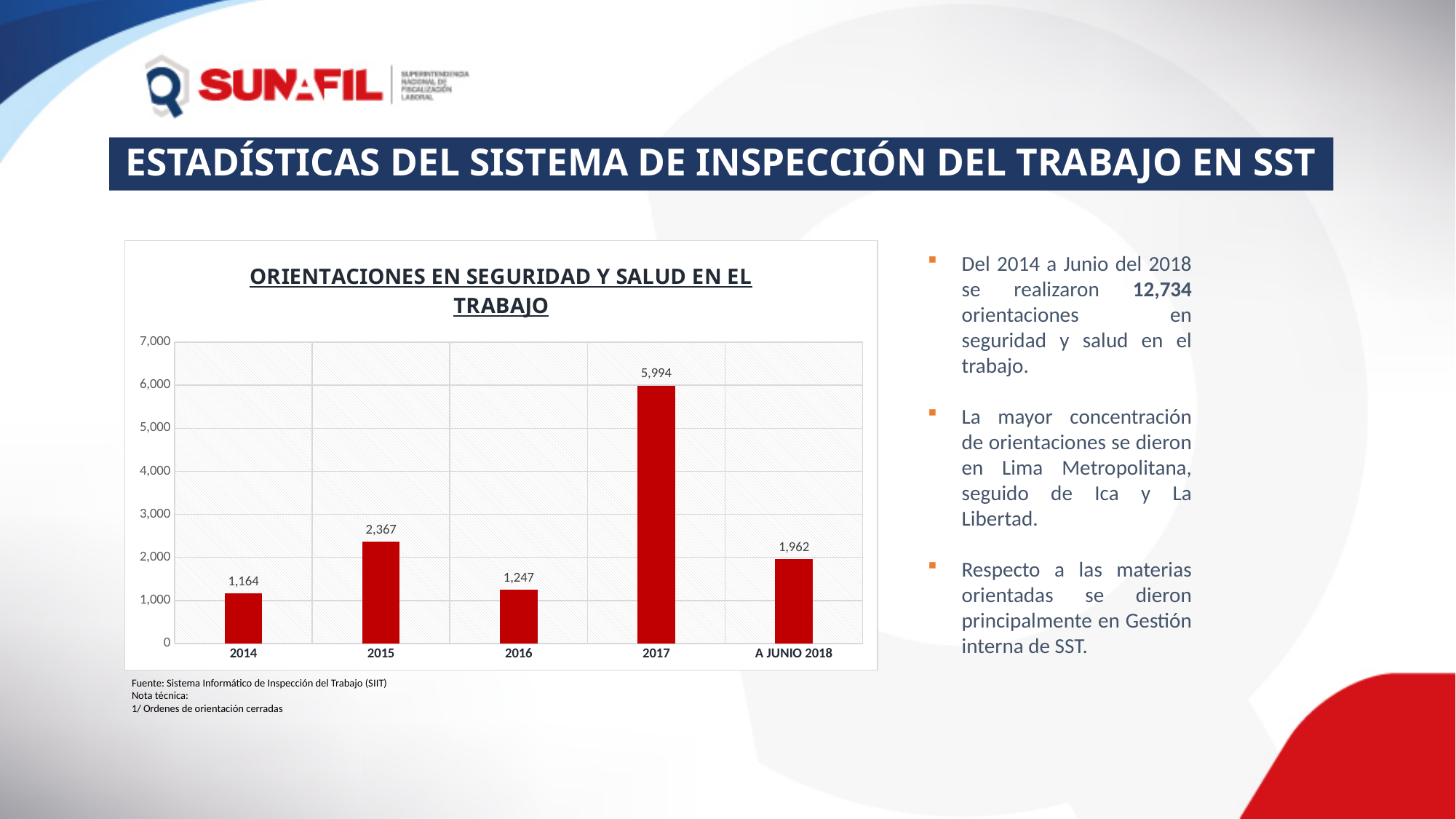
What is the difference between the values for 2017 and 2015? 3,627 What is the title of the chart? ORIENTACIONES EN SEGURIDAD Y SALUD EN EL TRABAJO What is the value for 2017? 5,994 What is the value for 2014? 1,164 What is the value for A JUNIO 2018? 1,962 Which year has the highest value? 2017 What is the difference between the values for 2016 and 2014? 83 What kind of chart is shown? bar chart How many categories are shown on the x axis? 5 Which category has the lowest value? 2014 Which is larger, the value for 2015 or the value for A JUNIO 2018? 2015 Is the value for 2017 greater or less than 5,000? greater